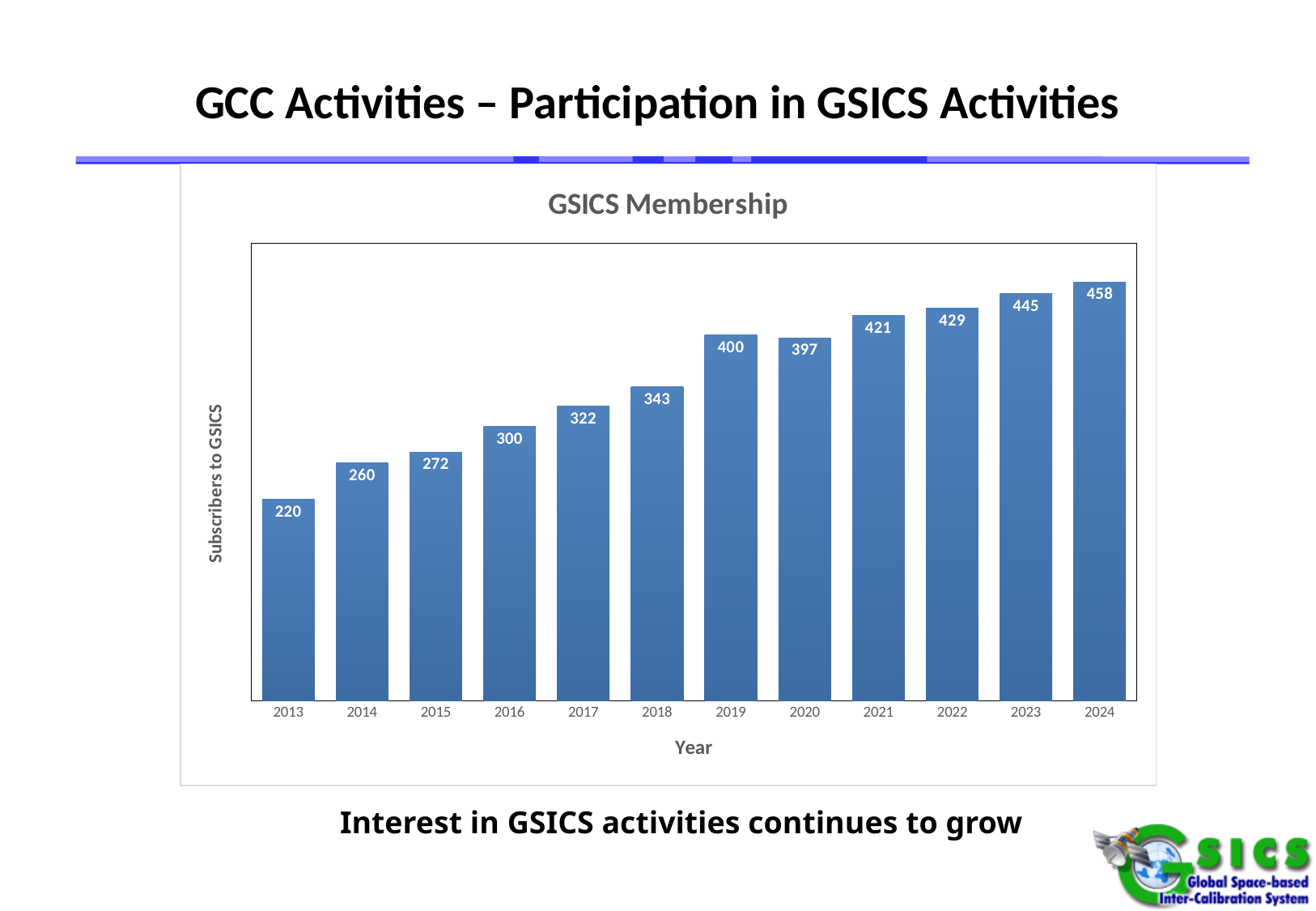
Which year has more subscribers, 2019 or 2020? 2019 What is the number of subscribers to GSICS in 2020? 397 What is the difference in subscribers between 2019 and 2020? 3 What is the number of subscribers to GSICS in 2013? 220 What is the title of the chart? GSICS Membership How many years are shown on the x axis of the chart? 12 Which year has the highest number of subscribers to GSICS? 2024 What is the difference in subscribers between 2024 and 2013? 238 What kind of chart is shown on the slide? Bar chart What is the number of subscribers to GSICS in 2024? 458 Which year has the lowest number of subscribers to GSICS? 2013 Do the subscriber numbers generally rise or fall from 2013 to 2024? Rise